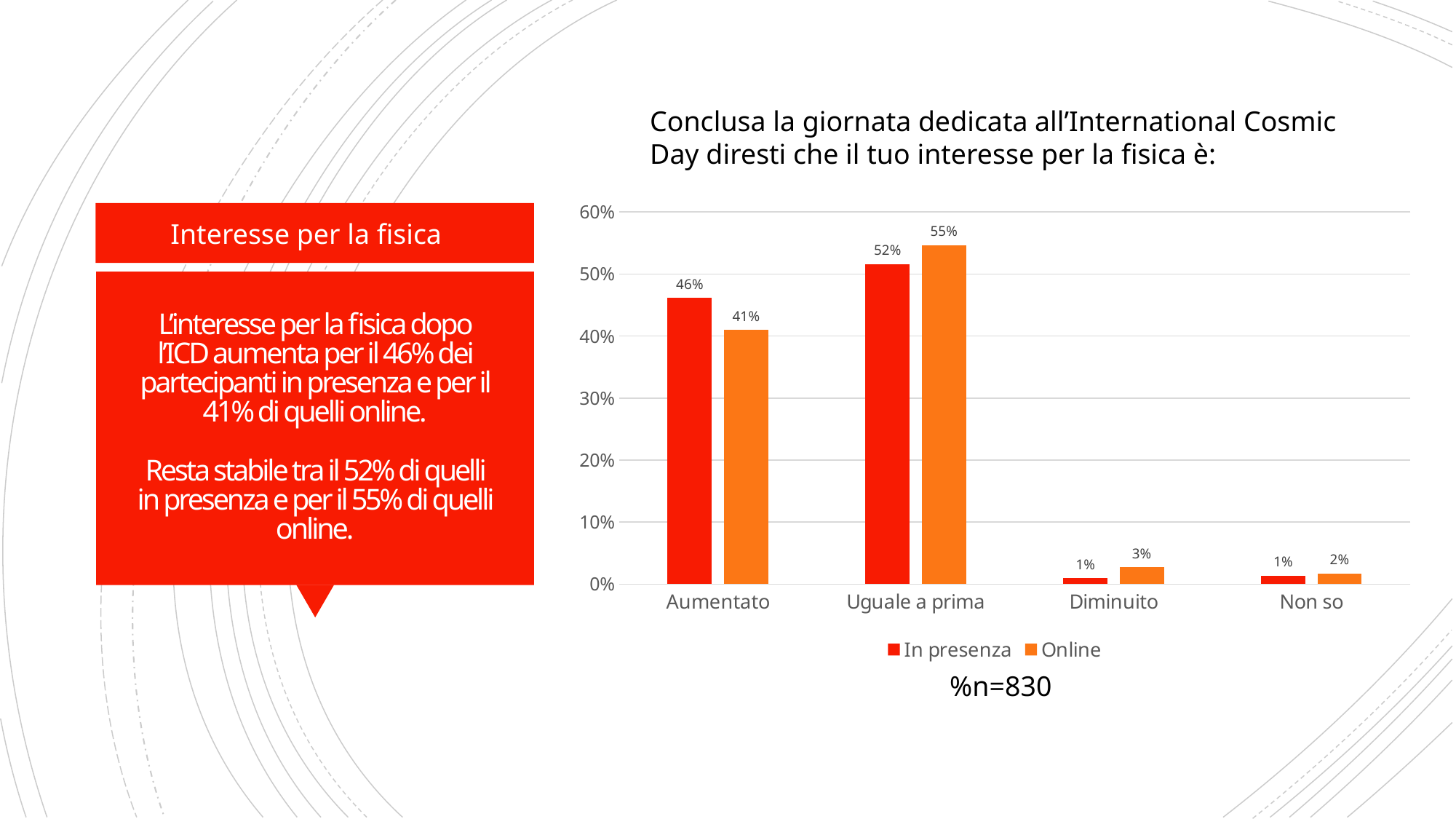
What is the value for 'In presenza' in the 'Non so' category? 1% What is the value for 'In presenza' in the 'Aumentato' category? 46% What kind of chart is shown on the slide? Bar chart How many categories are shown on the x axis? 4 In the 'Aumentato' category, which series has the larger value, 'In presenza' or 'Online'? In presenza What is the difference between the 'Online' and 'In presenza' values in the 'Aumentato' category? 5% What is the value for 'Online' in the 'Diminuito' category? 3% How many series does the legend list? 2 Is the 'In presenza' value for 'Uguale a prima' greater or less than 50%? greater Which category has the highest value for the 'Online' series? Uguale a prima What is the difference between the 'Online' and 'In presenza' values in the 'Uguale a prima' category? 3% What is the value for 'Online' in the 'Uguale a prima' category? 55%